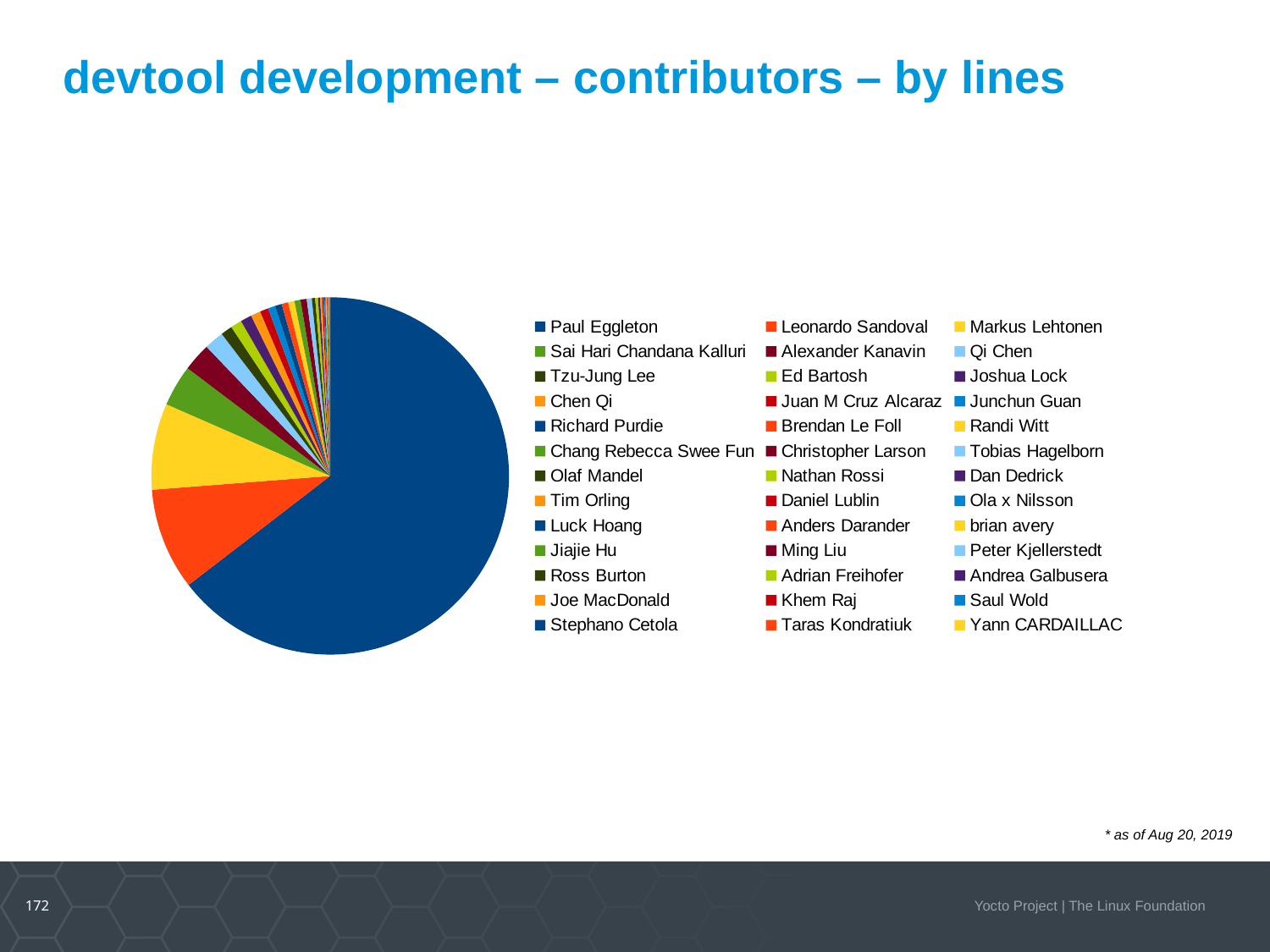
What kind of chart is shown on the slide? pie chart Does Paul Eggleton's slice take up more or less than half of the pie? more Which slice is larger, Leonardo Sandoval's or Sai Hari Chandana Kalluri's? Leonardo Sandoval What is the title of the slide containing the chart? devtool development – contributors – by lines How many contributors are listed in the chart's legend? 39 Which slice is larger, Paul Eggleton's or Leonardo Sandoval's? Paul Eggleton Which slice is larger, Sai Hari Chandana Kalluri's or Tzu-Jung Lee's? Sai Hari Chandana Kalluri Which contributor has the largest slice of the pie? Paul Eggleton What colour is the largest slice of the pie? dark blue